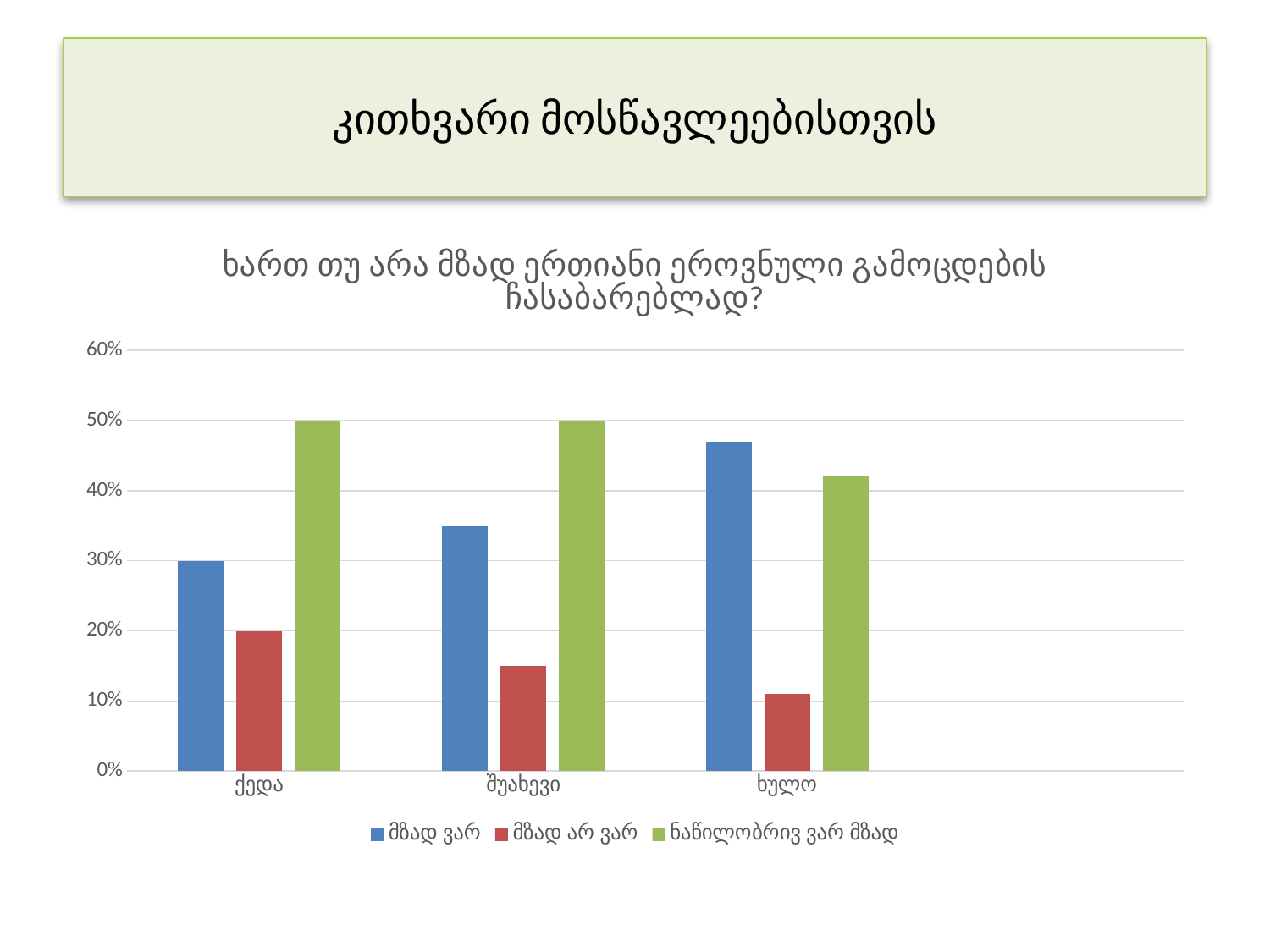
Which category has the highest value for მზად ვარ? ხულო What is the value for ნაწილობრივ ვარ მზად in შუახევი? 50% What is the value for მზად არ ვარ in ქედა? 20% What is the value for მზად ვარ in ქედა? 30% What is the value for ნაწილობრივ ვარ მზად in ქედა? 50% Which category has the lowest value for მზად არ ვარ? ხულო How many series does the chart legend list? 3 Which series is shown in green in the chart? ნაწილობრივ ვარ მზად Is the value for მზად ვარ in ხულო greater or less than 40%? greater How many categories are shown on the x axis of the chart? 3 What kind of chart is shown on the slide? bar chart Is the value for მზად არ ვარ in შუახევი greater or less than 20%? less